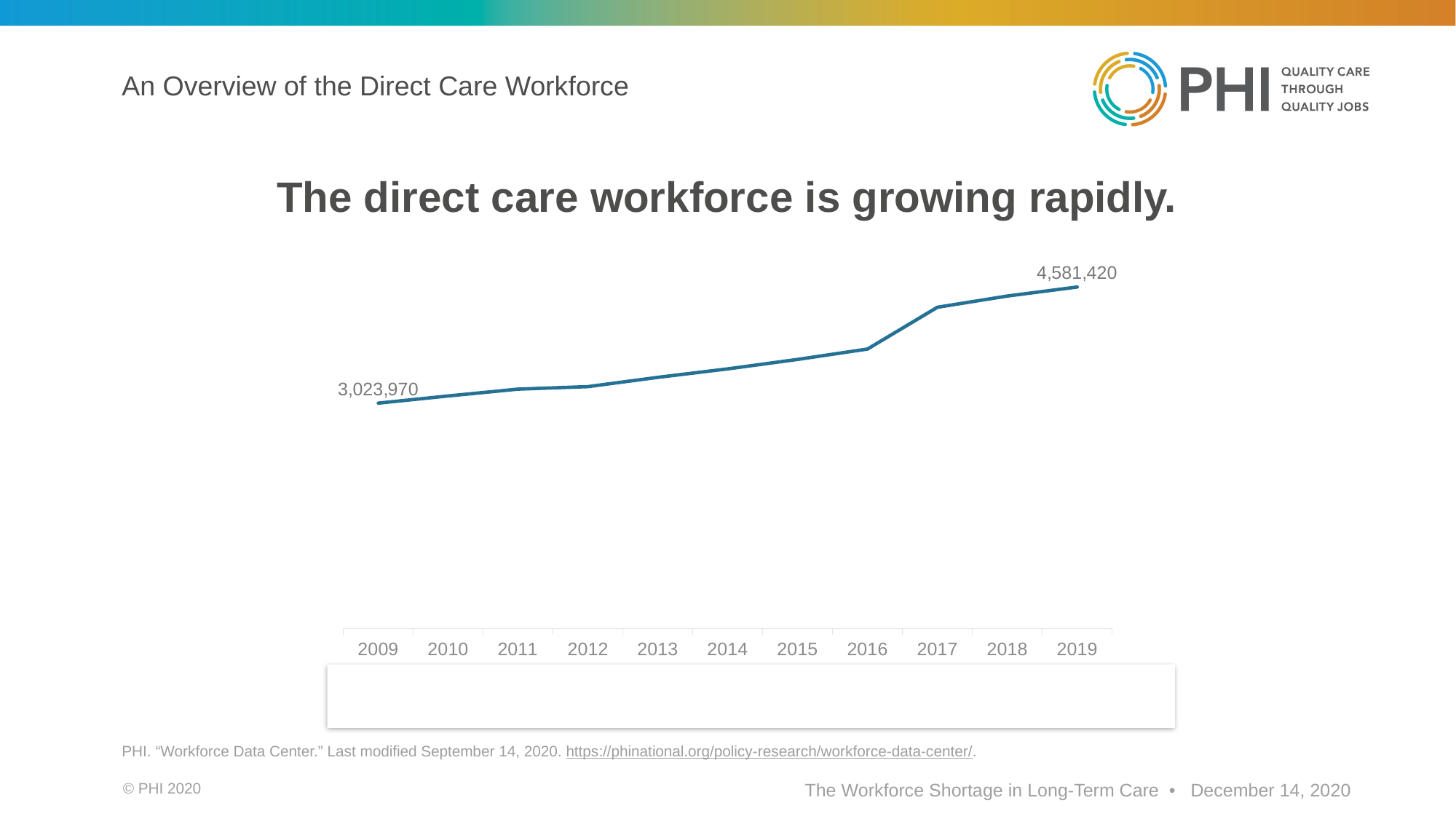
What is the first year shown on the x axis? 2009 What kind of chart is shown on the slide? Line chart By how much did the direct care workforce grow from 2009 to 2019? 1,557,450 Which is larger, the value for 2009 or the value for 2019? 2019 How many years are shown on the x axis of the chart? 11 What is the title of the chart on the slide? The direct care workforce is growing rapidly. What is the value of the direct care workforce in 2019? 4,581,420 Do the values rise or fall from 2009 to 2019? Rise Which year has the lowest value on the chart? 2009 What is the value of the direct care workforce in 2009? 3,023,970 Which is larger, the value for 2016 or the value for 2017? 2017 Which year has the highest value on the chart? 2019